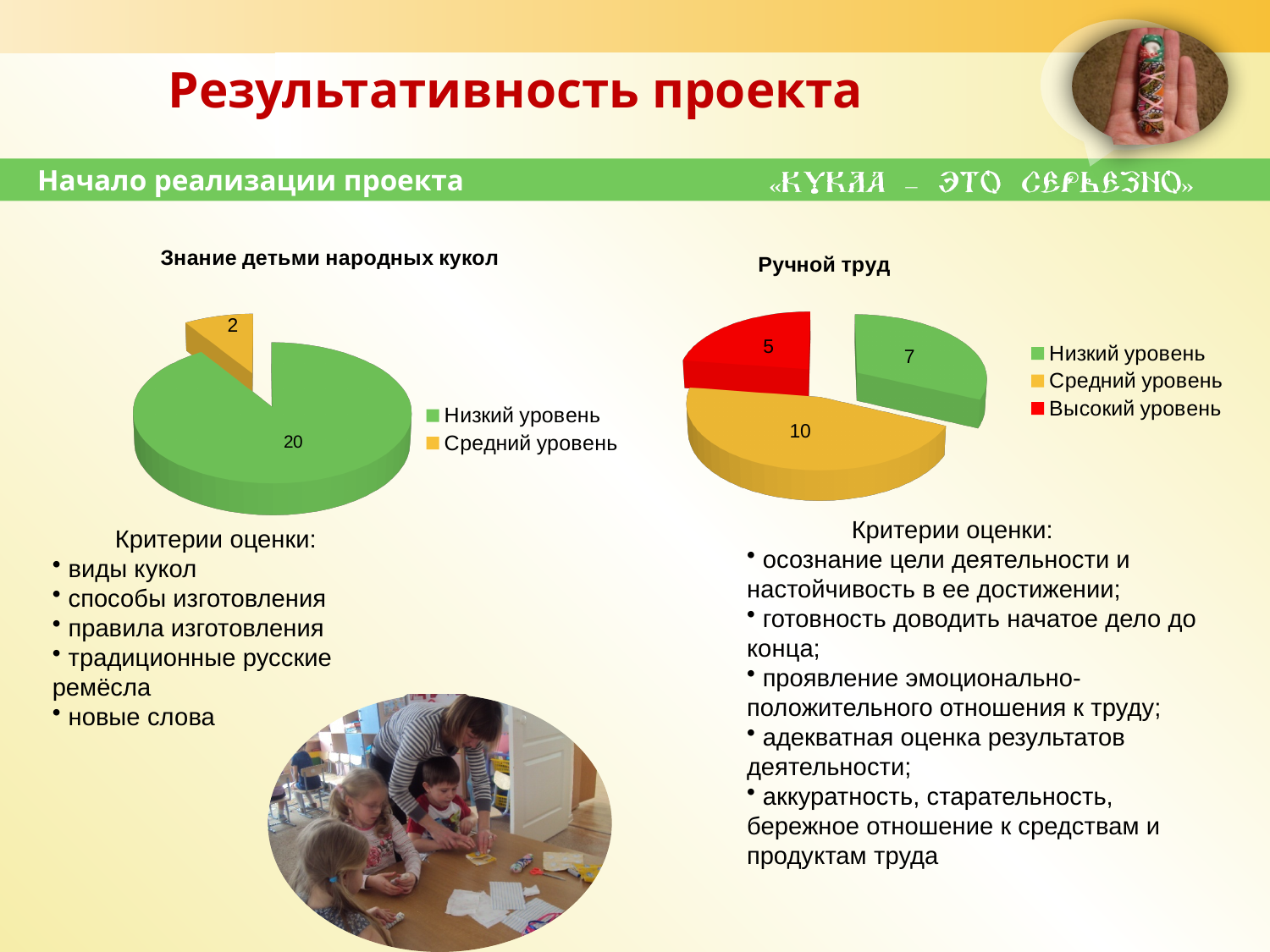
In the chart titled "Ручной труд", what is the difference between Средний уровень and Низкий уровень? 3 How many categories does the chart titled "Ручной труд" show? 3 What type of chart is the chart titled "Ручной труд"? Pie chart In the chart titled "Знание детьми народных кукол", what is the value for Средний уровень? 2 In the chart titled "Ручной труд", which category has the highest value? Средний уровень In the chart titled "Ручной труд", what is the value for Средний уровень? 10 In the chart titled "Знание детьми народных кукол", what is the difference between Низкий уровень and Средний уровень? 18 In the chart titled "Ручной труд", which is larger: Низкий уровень or Высокий уровень? Низкий уровень In the chart titled "Ручной труд", which category has the lowest value? Высокий уровень In the chart titled "Знание детьми народных кукол", what is the value for Низкий уровень? 20 In the chart titled "Ручной труд", what is the value for Высокий уровень? 5 How many entries does the legend of the chart titled "Знание детьми народных кукол" list? 2